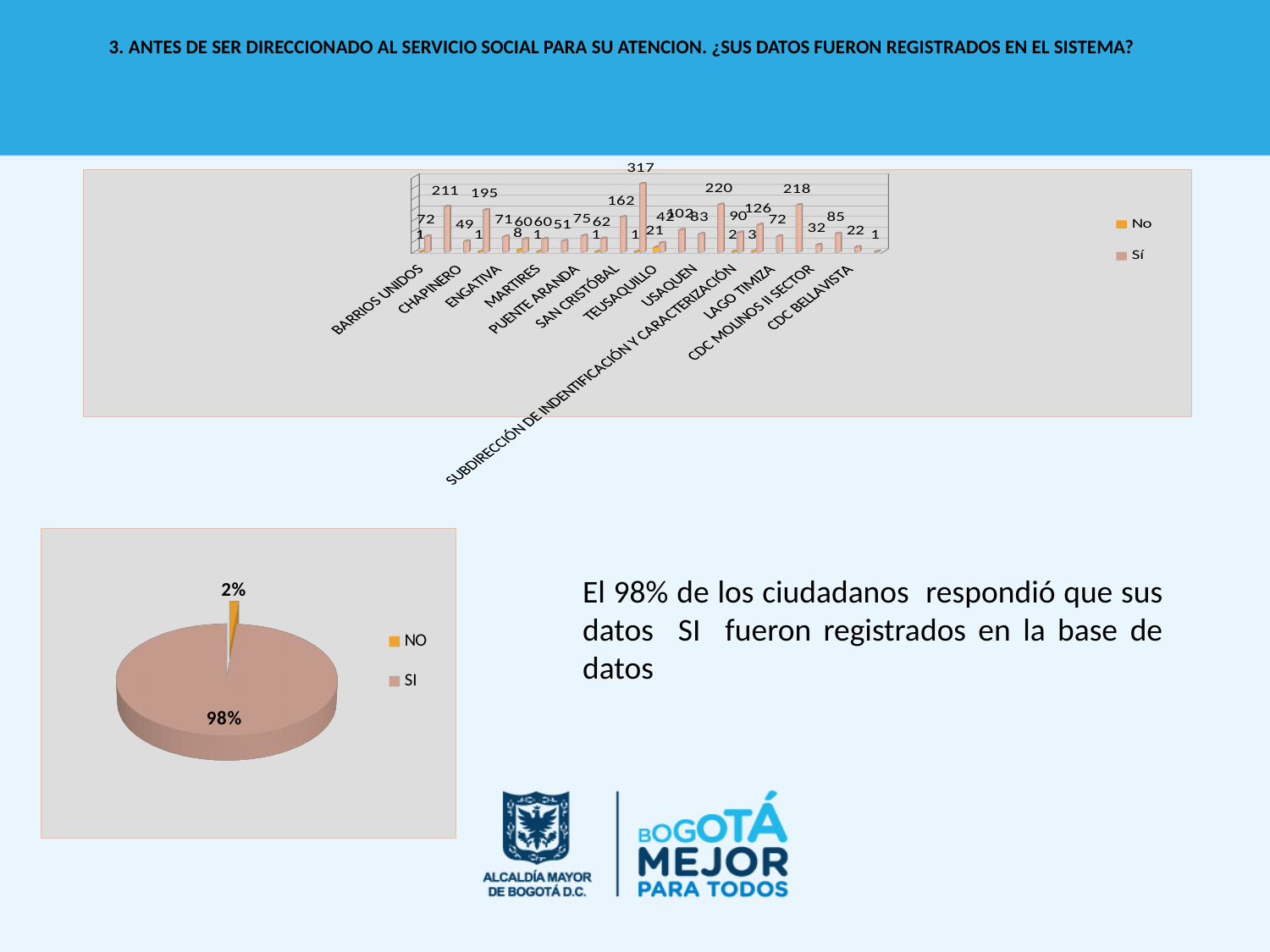
In the top bar chart, what is the first category label on the x axis? BARRIOS UNIDOS In the bottom-left pie chart, what share of the pie does SI have? 98% What kind of chart is the top chart on the slide? Bar chart What kind of chart is the bottom-left chart on the slide? Pie chart How many series does the legend of the top bar chart list? 2 In the bottom-left pie chart, which slice is larger, NO or SI? SI In the top bar chart, what is the Sí value for BARRIOS UNIDOS? 72 In the bottom-left pie chart, what share of the pie does NO have? 2% In the bottom-left pie chart, what is the difference in percentage points between the SI and NO slices? 96 percentage points What are the two legend entries of the top bar chart? No and Sí How many entries does the legend of the bottom-left pie chart list? 2 In the top bar chart, what is the highest data label shown? 317